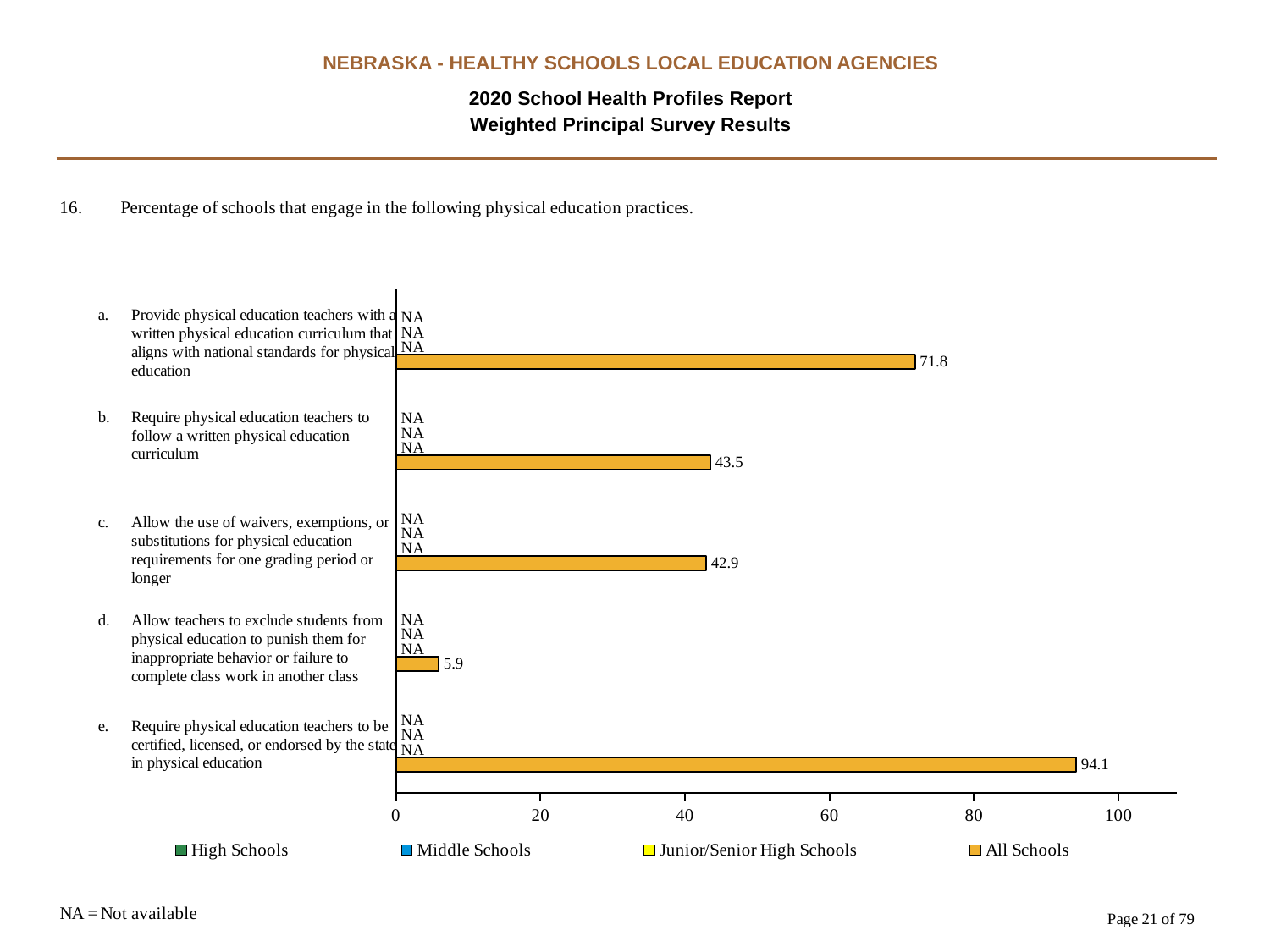
What is the All Schools value for practice e, requiring physical education teachers to be certified, licensed, or endorsed by the state in physical education? 94.1 What is the All Schools value for practice a, providing physical education teachers with a written physical education curriculum that aligns with national standards? 71.8 Which practice has the highest All Schools percentage? e. Require physical education teachers to be certified, licensed, or endorsed by the state in physical education How many series does the legend list? 4 Which practice has the lowest All Schools percentage? d. Allow teachers to exclude students from physical education to punish them for inappropriate behavior or failure to complete class work in another class Which has a larger All Schools value: practice b (require teachers to follow a written curriculum) or practice c (allow waivers, exemptions, or substitutions)? Practice b (43.5) What is the All Schools value for practice d, allowing teachers to exclude students from physical education to punish them? 5.9 What is the difference between the All Schools values for practice e (94.1) and practice a (71.8)? 22.3 What value is shown for High Schools, Middle Schools, and Junior/Senior High Schools for every practice? NA Is the All Schools value for practice b greater or less than 40? greater How many practices (categories) are shown on the chart? 5 What kind of chart is shown on the slide? Bar chart